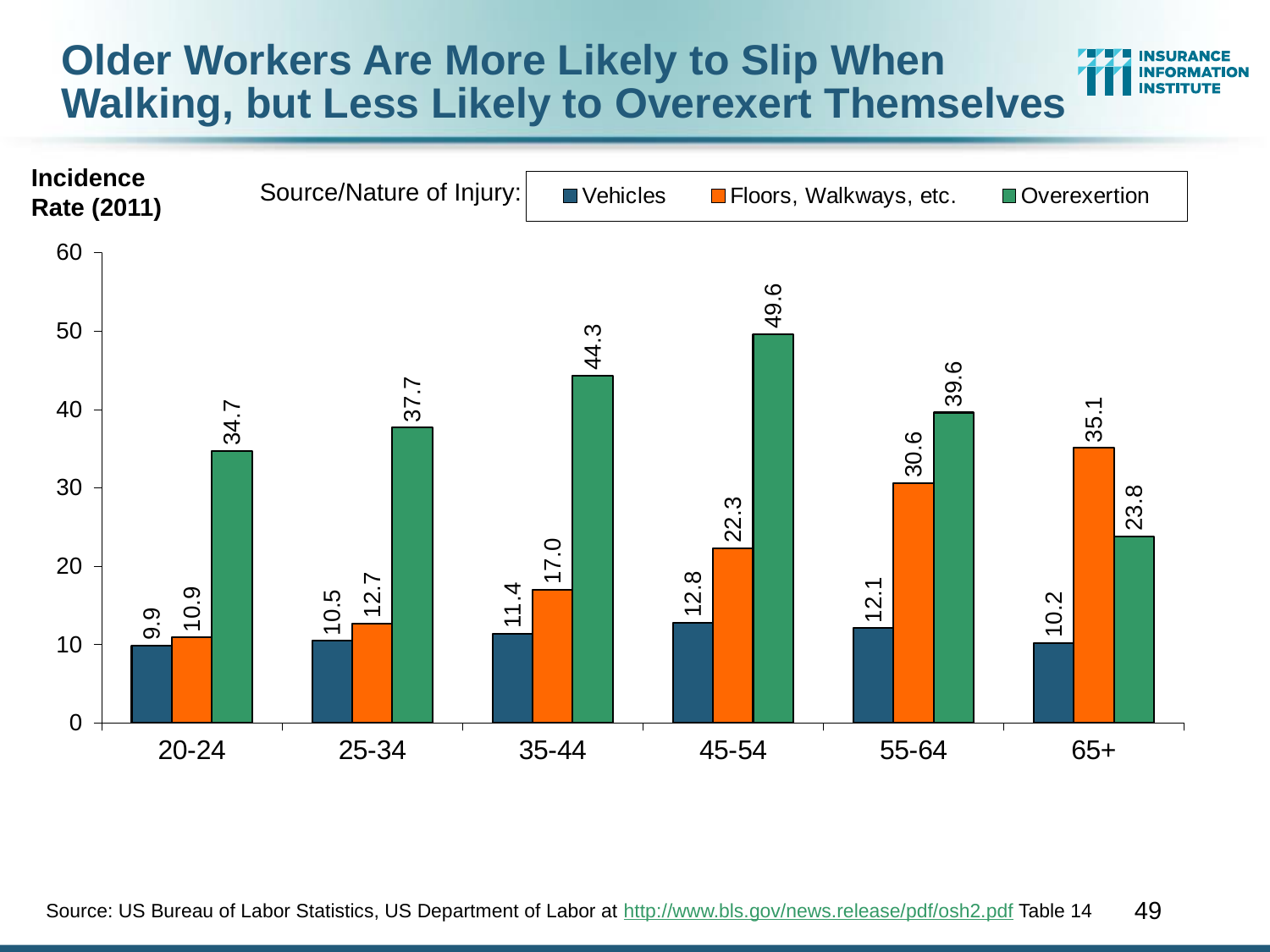
Does the Floors, Walkways, etc. incidence rate rise or fall as age group increases from 20-24 to 65+? Rises How many series does the legend list? 3 What is the difference between the Overexertion and Floors, Walkways, etc. incidence rates for the 55-64 age group? 9.0 What is the Floors, Walkways, etc. incidence rate for the 65+ age group? 35.1 What kind of chart is shown on the slide? Bar chart For the 65+ age group, which is larger: the Floors, Walkways, etc. rate or the Overexertion rate? Floors, Walkways, etc. What is the Overexertion incidence rate for the 45-54 age group? 49.6 What is the Vehicles incidence rate for the 20-24 age group? 9.9 Which age group has the highest Overexertion incidence rate? 45-54 Is the Overexertion incidence rate for the 35-44 age group greater or less than 40? greater How many age groups are shown on the x axis? 6 Which age group has the lowest Floors, Walkways, etc. incidence rate? 20-24